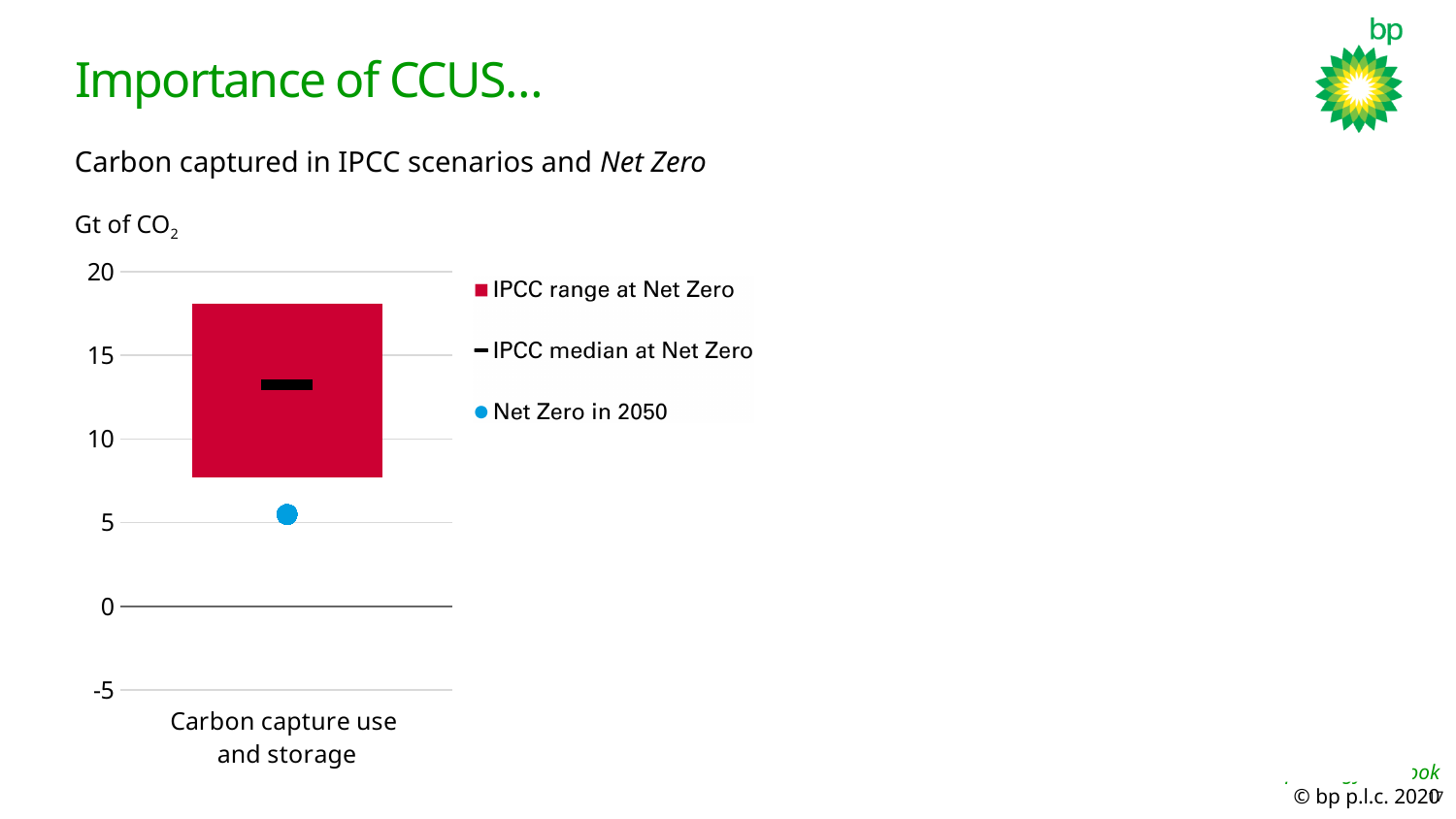
Is the bottom of the IPCC range at Net Zero greater or less than 5? greater Is the top of the IPCC range at Net Zero greater or less than 15? greater How many series does the legend list? 3 What is the highest tick value shown on the y axis? 20 What is the category label on the x axis? Carbon capture use and storage Is the value for Net Zero in 2050 greater or less than 10? less What unit is shown for the y axis? Gt of CO2 Which series has the lowest value on the chart? Net Zero in 2050 Which is larger, the IPCC median at Net Zero or Net Zero in 2050? IPCC median at Net Zero How many categories are shown on the x axis? 1